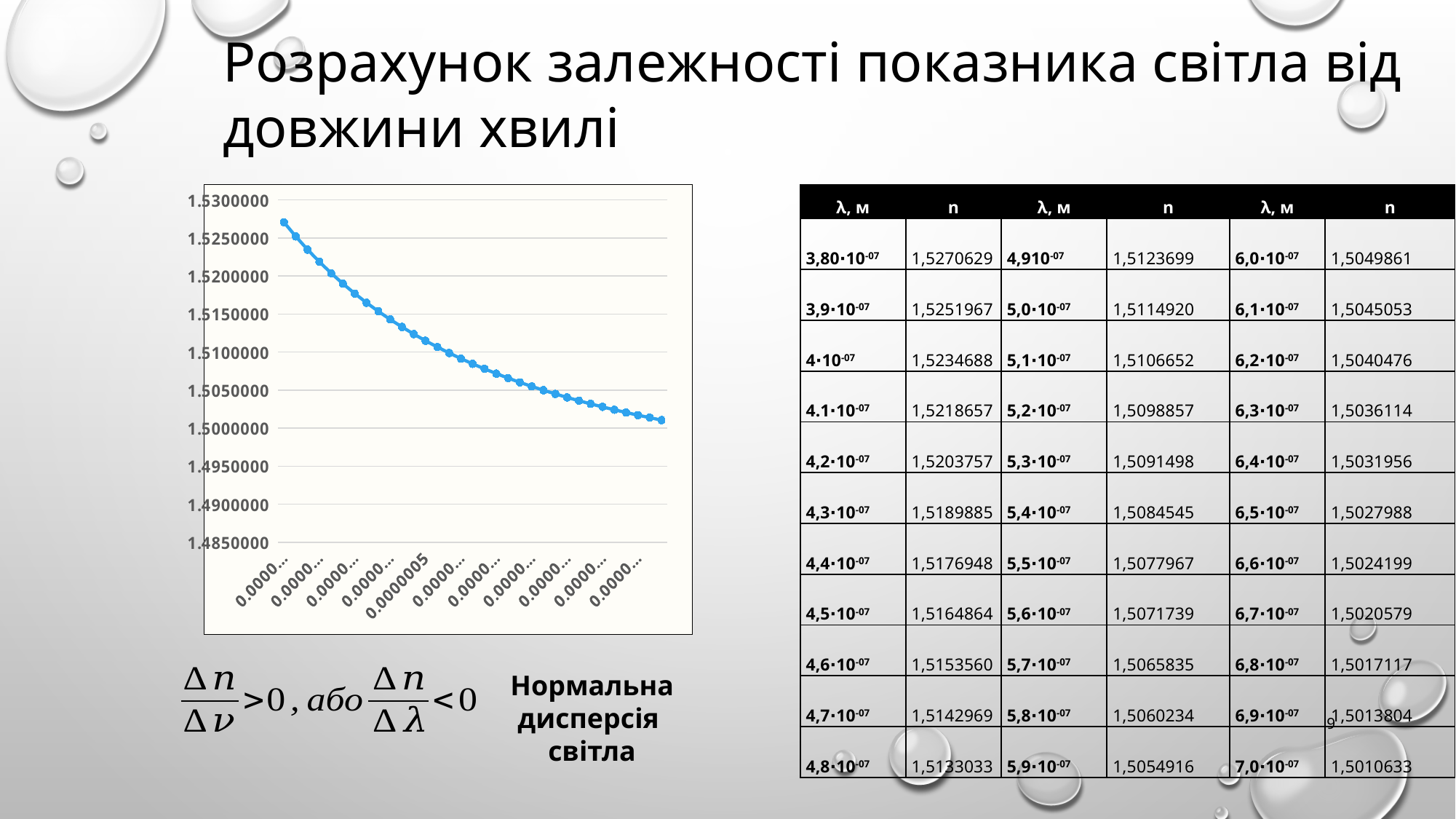
Is the value of the point at x = 0.0000005 greater or less than 1.5100000? greater Is the value of the rightmost point on the chart greater or less than 1.5000000? greater What is the lowest tick value shown on the y axis of the chart? 1.4850000 Which is larger: the value of the leftmost point or the value of the rightmost point? the leftmost point What kind of chart is shown on the slide? line chart Do the plotted values rise or fall as you move from left to right along the x axis? fall Which point on the chart has the highest value? the leftmost (first) point Which point on the chart has the lowest value? the rightmost (last) point What is the highest tick value shown on the y axis of the chart? 1.5300000 Is the value of the leftmost point on the chart greater or less than 1.5250000? greater